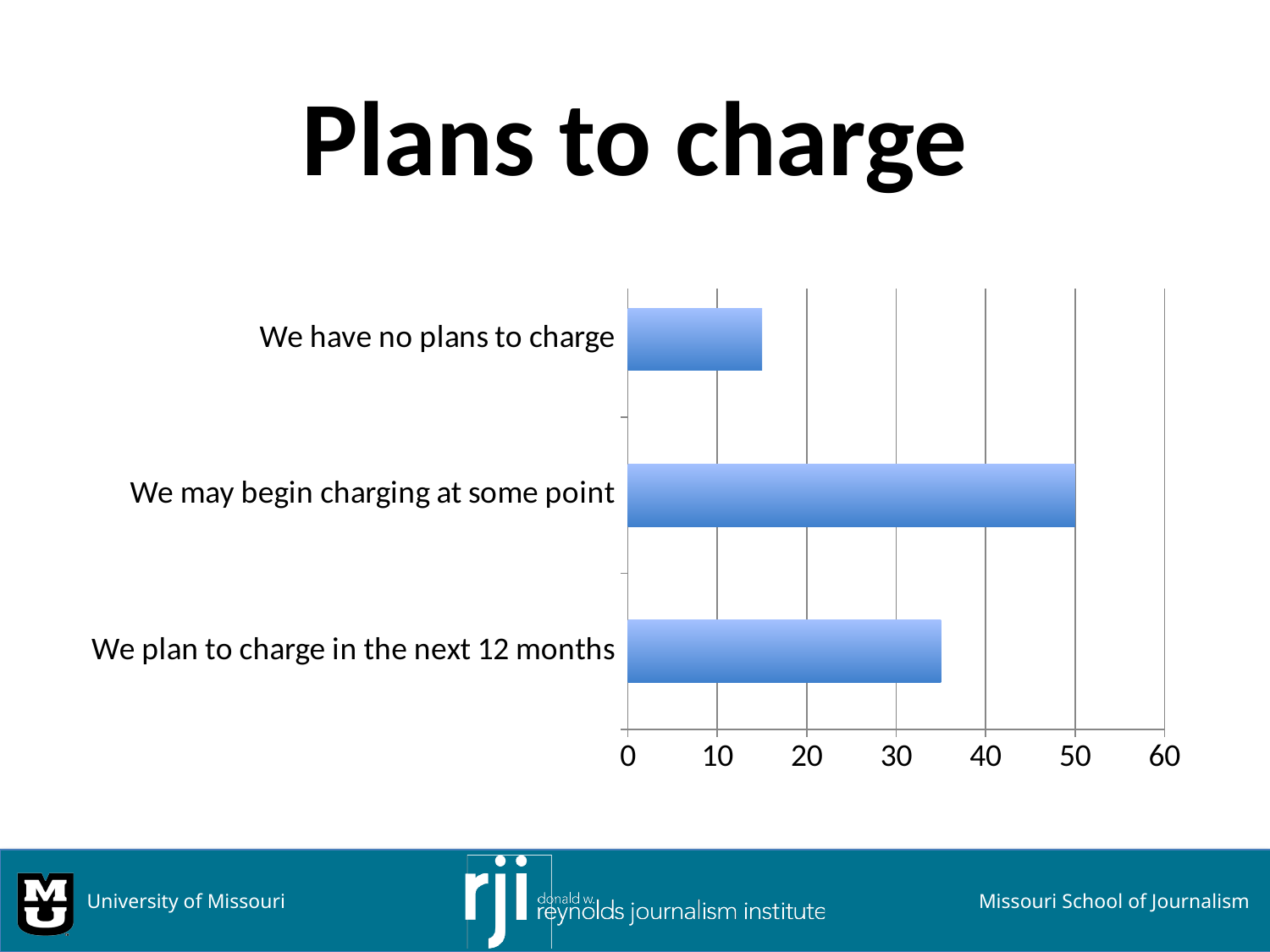
What is the title of the chart? Plans to charge Is the value for "We plan to charge in the next 12 months" greater or less than 40? less What kind of chart is shown on the slide? bar chart Is the value for "We plan to charge in the next 12 months" greater or less than 30? greater Which category has the highest value? We may begin charging at some point How many categories does the chart show? 3 What is the maximum value shown on the horizontal axis? 60 Which is larger: the value for "We may begin charging at some point" or the value for "We plan to charge in the next 12 months"? We may begin charging at some point What is the value for "We may begin charging at some point"? 50 Is the value for "We have no plans to charge" greater or less than 20? less Which is larger: the value for "We plan to charge in the next 12 months" or the value for "We have no plans to charge"? We plan to charge in the next 12 months Which category has the lowest value? We have no plans to charge